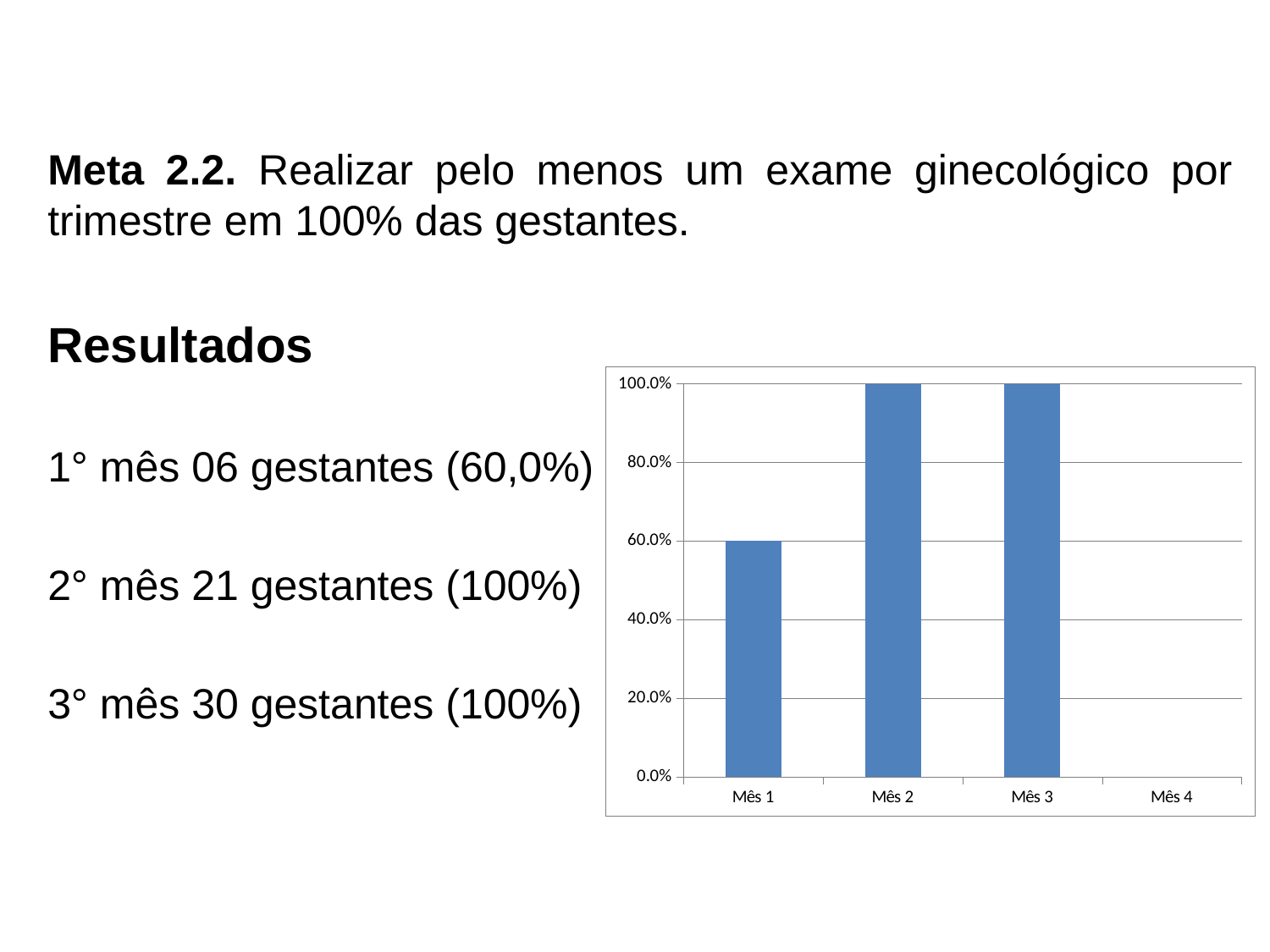
What is the label of the last category on the x axis of the chart? Mês 4 Which is larger, the value for Mês 1 or the value for Mês 2? Mês 2 Is the value for Mês 1 greater or less than 80.0%? less Is the value for Mês 3 greater or less than 80.0%? greater What kind of chart is shown on the slide? bar chart What is the highest tick value shown on the y axis of the chart? 100.0% What is the value for Mês 1 in the chart? 60.0% What is the difference between the values for Mês 2 and Mês 1? 40.0% How many categories are shown on the x axis of the chart? 4 What is the value for Mês 2 in the chart? 100.0% Does the value rise or fall from Mês 1 to Mês 2? rise What is the value for Mês 3 in the chart? 100.0%